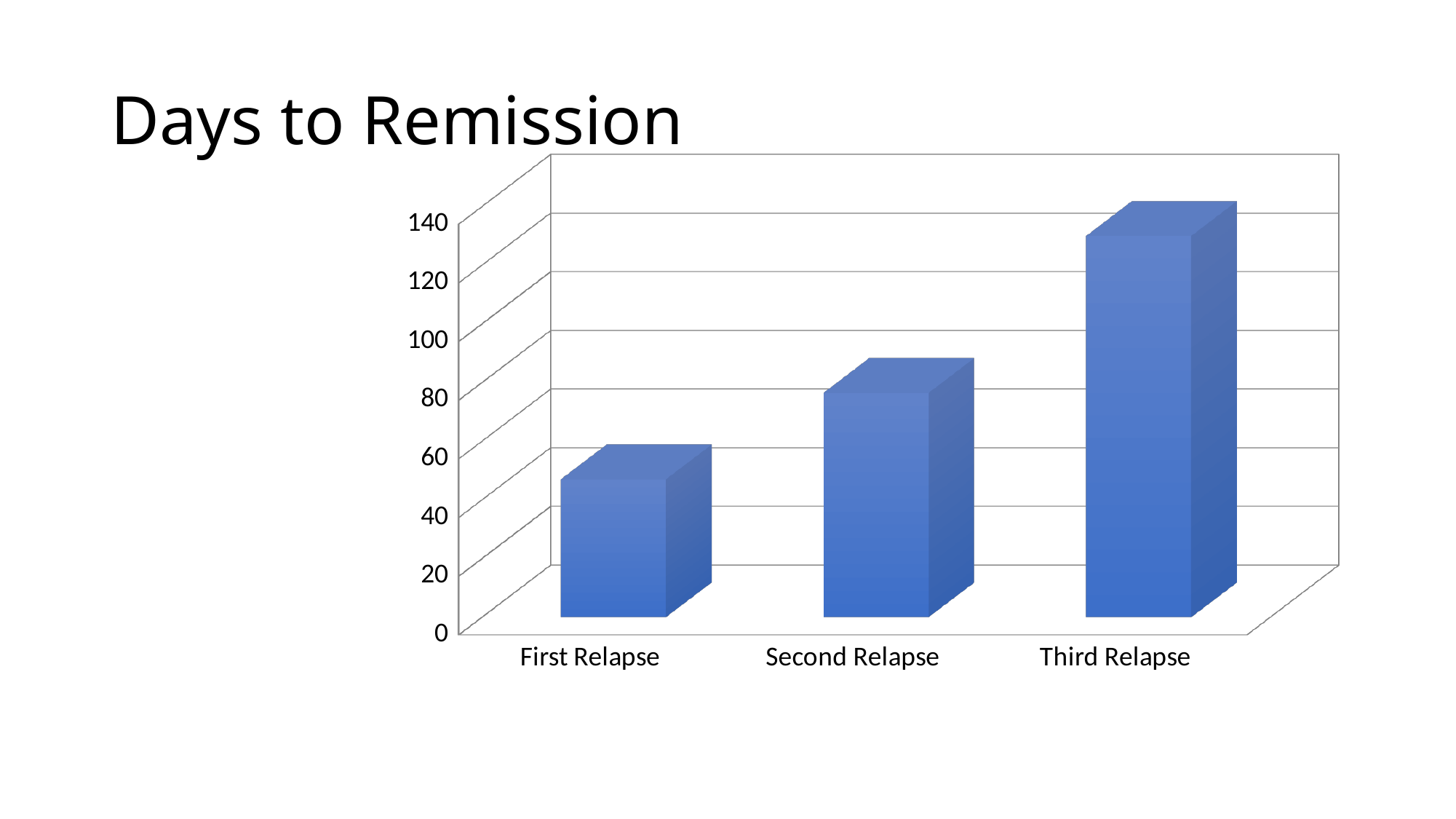
What is the title of the chart? Days to Remission Is the value for First Relapse greater or less than 80? less Is the value for Second Relapse greater or less than 40? greater Which category has the highest value? Third Relapse How many categories are shown on the x axis? 3 Which is larger, the value for Second Relapse or the value for First Relapse? Second Relapse Is the value for Second Relapse greater or less than 120? less Do the values rise or fall from First Relapse to Third Relapse? rise Which category has the lowest value? First Relapse Which is larger, the value for Third Relapse or the value for Second Relapse? Third Relapse What kind of chart is shown on the slide? bar chart